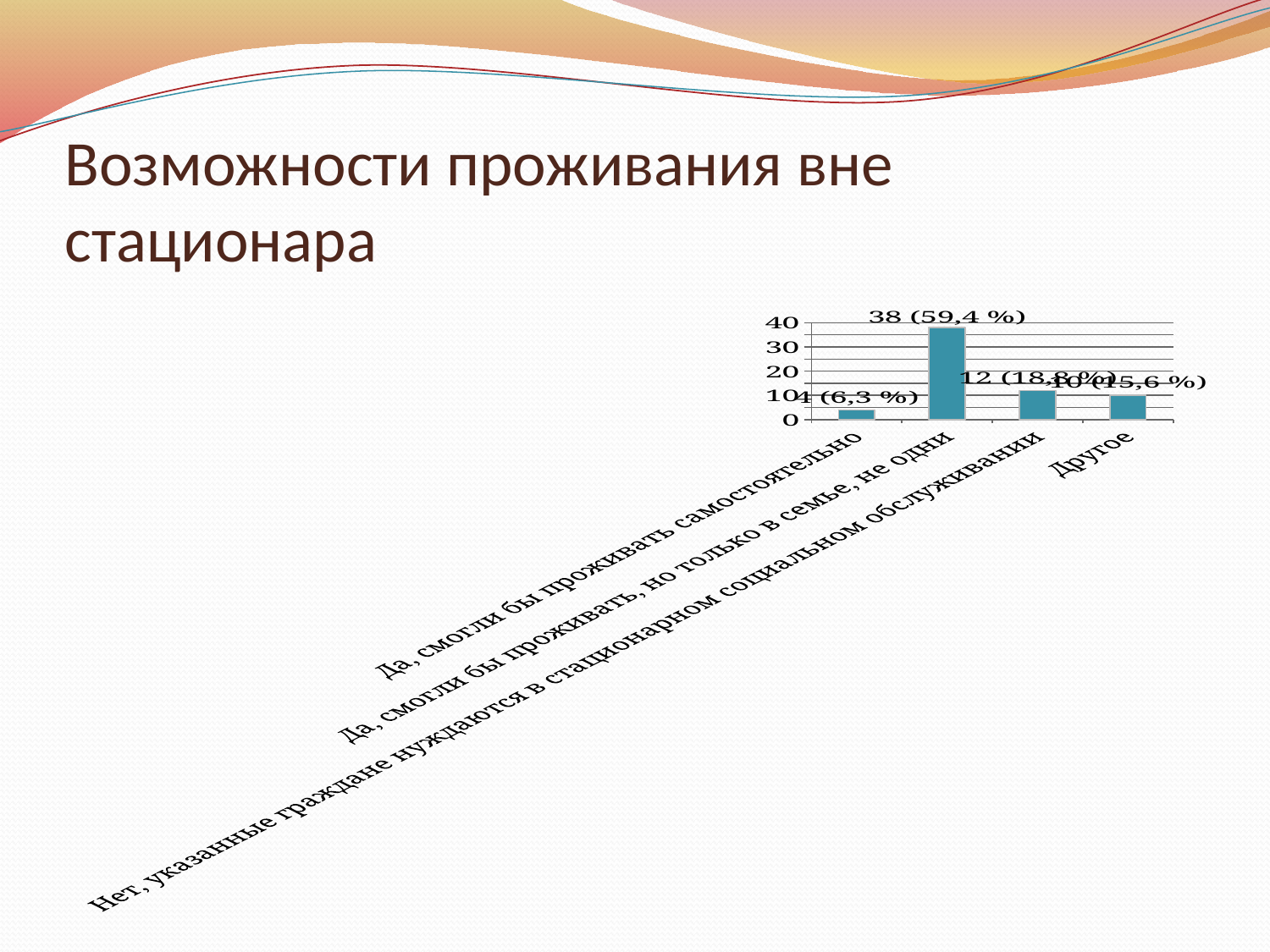
What type of chart is shown on the slide? bar chart What is the data label for the category "Другое"? 10 (15,6 %) Which is larger: the value for "Нет, указанные граждане нуждаются в стационарном социальном обслуживании" or the value for "Другое"? Нет, указанные граждане нуждаются в стационарном социальном обслуживании What is the data label for the category "Да, смогли бы проживать, но только в семье, не одни"? 38 (59,4 %) What is the data label for the category "Да, смогли бы проживать самостоятельно"? 4 (6,3 %) What is the difference in count between "Да, смогли бы проживать, но только в семье, не одни" and "Нет, указанные граждане нуждаются в стационарном социальном обслуживании"? 26 Which category has the lowest value? Да, смогли бы проживать самостоятельно How many categories are shown in the chart? 4 What is the title of the slide containing the chart? Возможности проживания вне стационара What is the data label for the category "Нет, указанные граждане нуждаются в стационарном социальном обслуживании"? 12 (18,8 %) Which category has the highest value? Да, смогли бы проживать, но только в семье, не одни Is the value for "Да, смогли бы проживать, но только в семье, не одни" greater or less than 30? greater